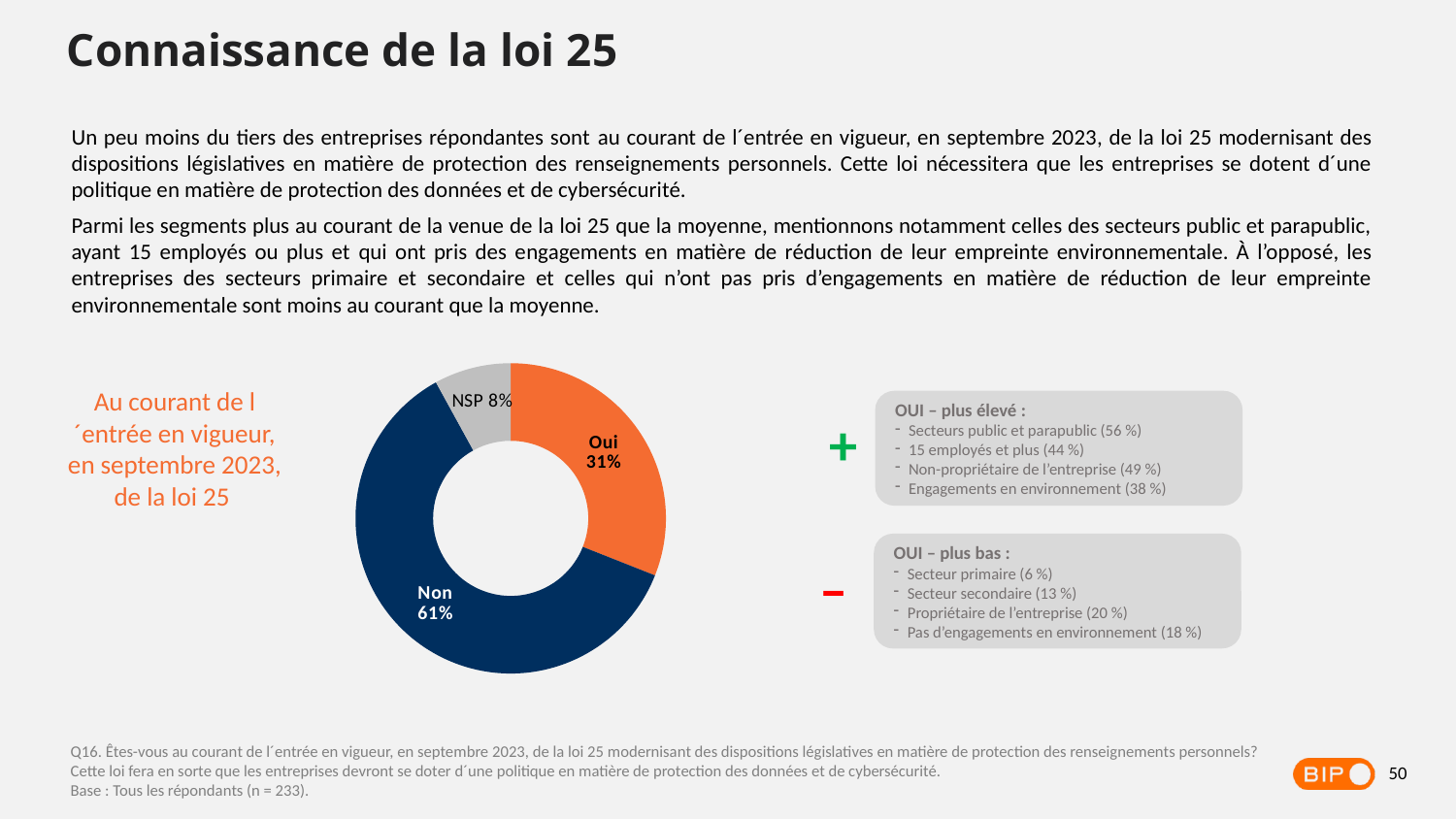
What percentage of respondents answered "Non" in the donut chart? 61% Which is larger, the share for "Oui" or the share for "NSP"? Oui Which response has the smallest share in the donut chart? NSP What is the base (n) of respondents for the chart? n = 233 How many categories are shown in the donut chart? 3 What percentage of respondents answered "Oui" in the donut chart? 31% Which response has the largest share in the donut chart? Non What colour is the "Oui" slice in the donut chart? Orange What is the difference in percentage points between the "Non" and "Oui" shares? 30 What is the combined share of "Oui" and "Non" in the donut chart? 92% What type of chart is used on this slide? Donut (pie) chart What percentage of respondents answered "NSP" in the donut chart? 8%